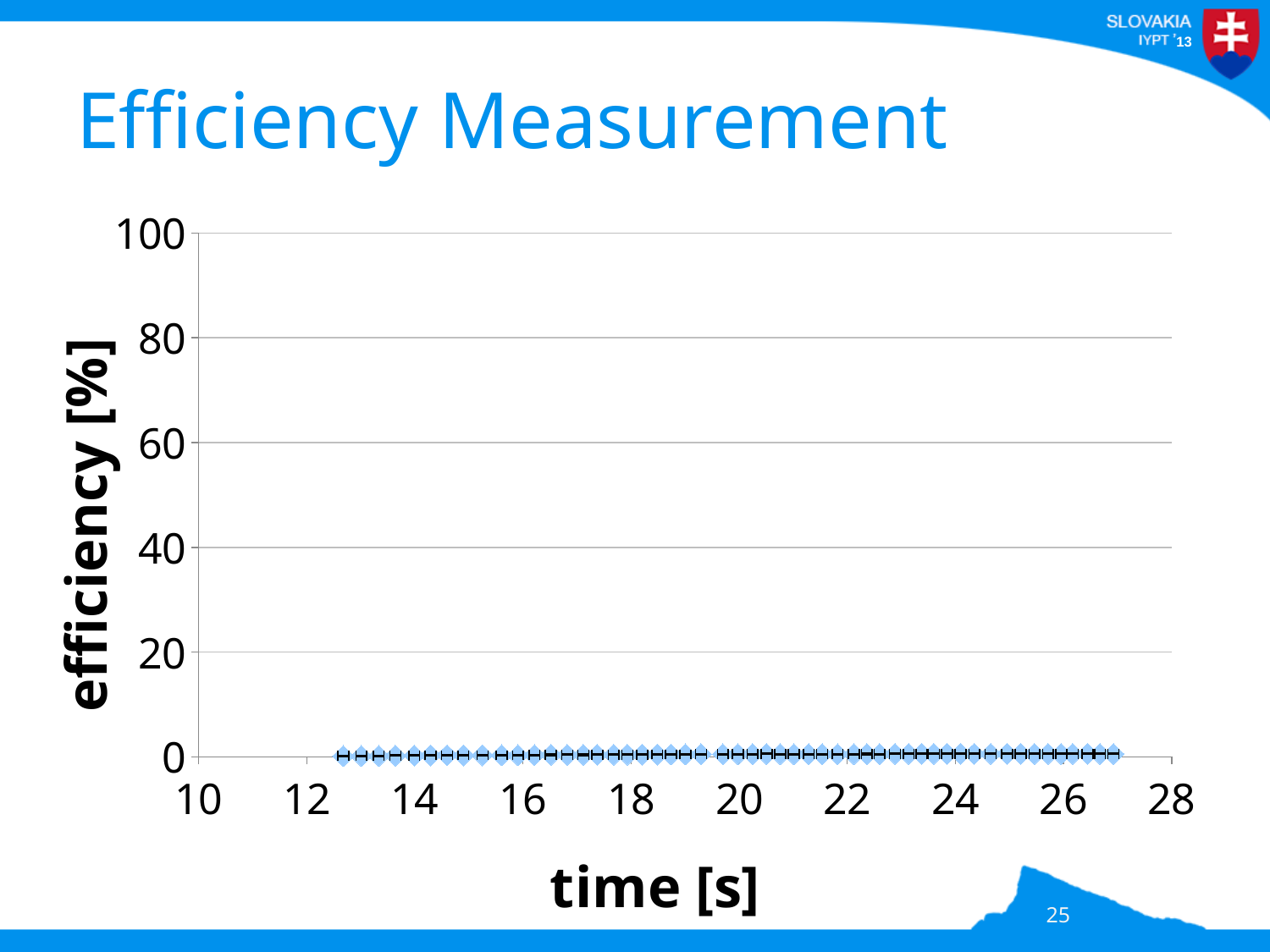
Is the efficiency value at time 14 s greater or less than 40? less What kind of chart is shown on the slide? scatter chart What is the label of the vertical axis? efficiency [%] Are any of the plotted efficiency values greater than 20? no Is the efficiency value at time 20 s greater or less than 20? less What is the highest value shown on the vertical axis? 100 What is the title of the slide containing the chart? Efficiency Measurement